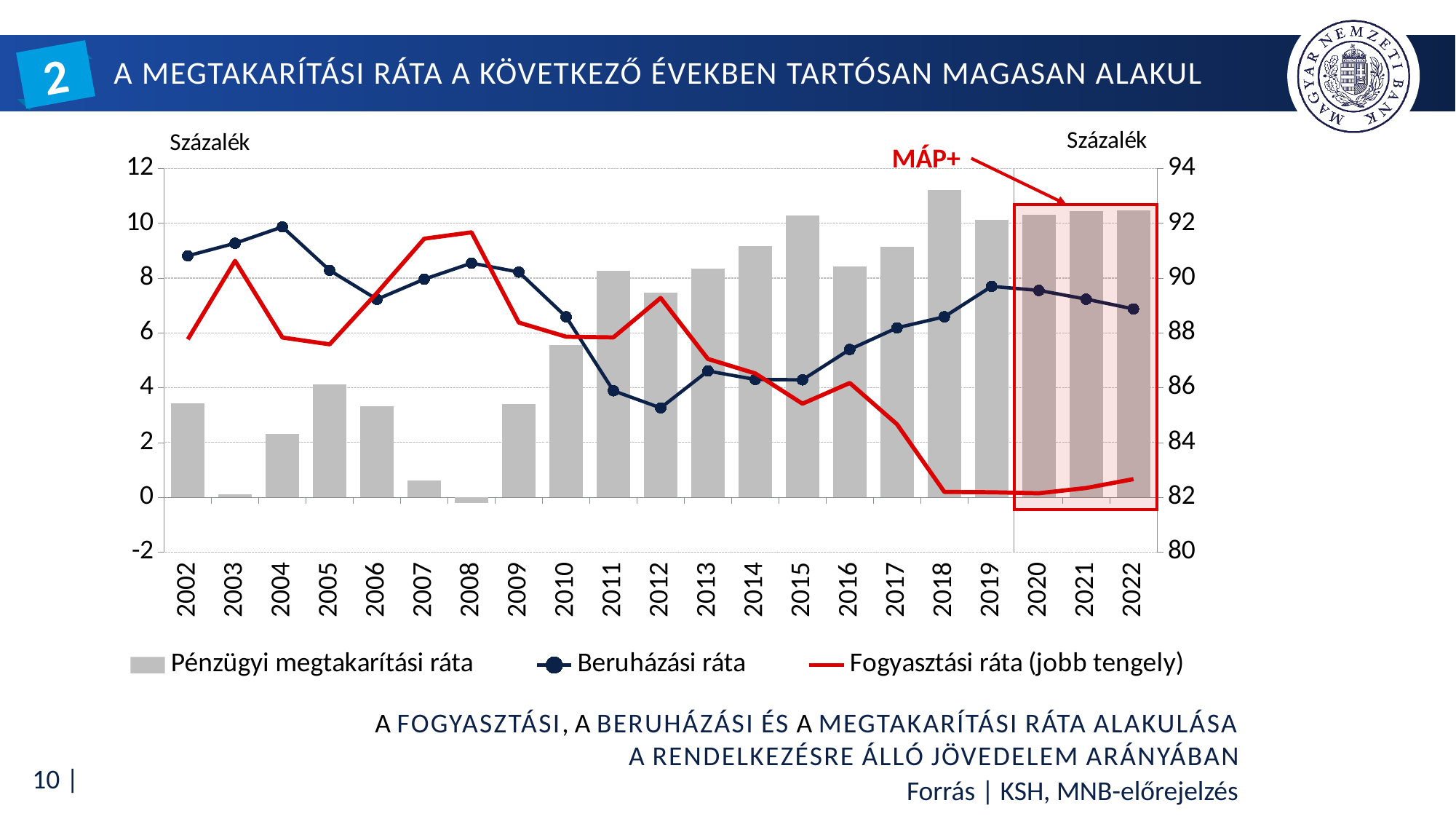
Does the Fogyasztási ráta rise or fall between 2012 and 2018? It falls Which year has the larger Pénzügyi megtakarítási ráta bar, 2011 or 2012? 2011 How many series does the legend list? 3 How many years are shown on the x axis? 21 Is the Pénzügyi megtakarítási ráta for 2018 greater or less than 10? greater In which year is the Pénzügyi megtakarítási ráta bar the highest? 2018 In which year is the Beruházási ráta at its lowest? 2012 In which year is the Beruházási ráta at its highest? 2004 Is the Pénzügyi megtakarítási ráta for 2002 greater or less than 4? less Is the Fogyasztási ráta for 2018 greater or less than 84 on the right axis? less Which series is plotted on the right axis according to the legend? Fogyasztási ráta (jobb tengely) What kind of chart is shown on the slide? A combined bar and line chart